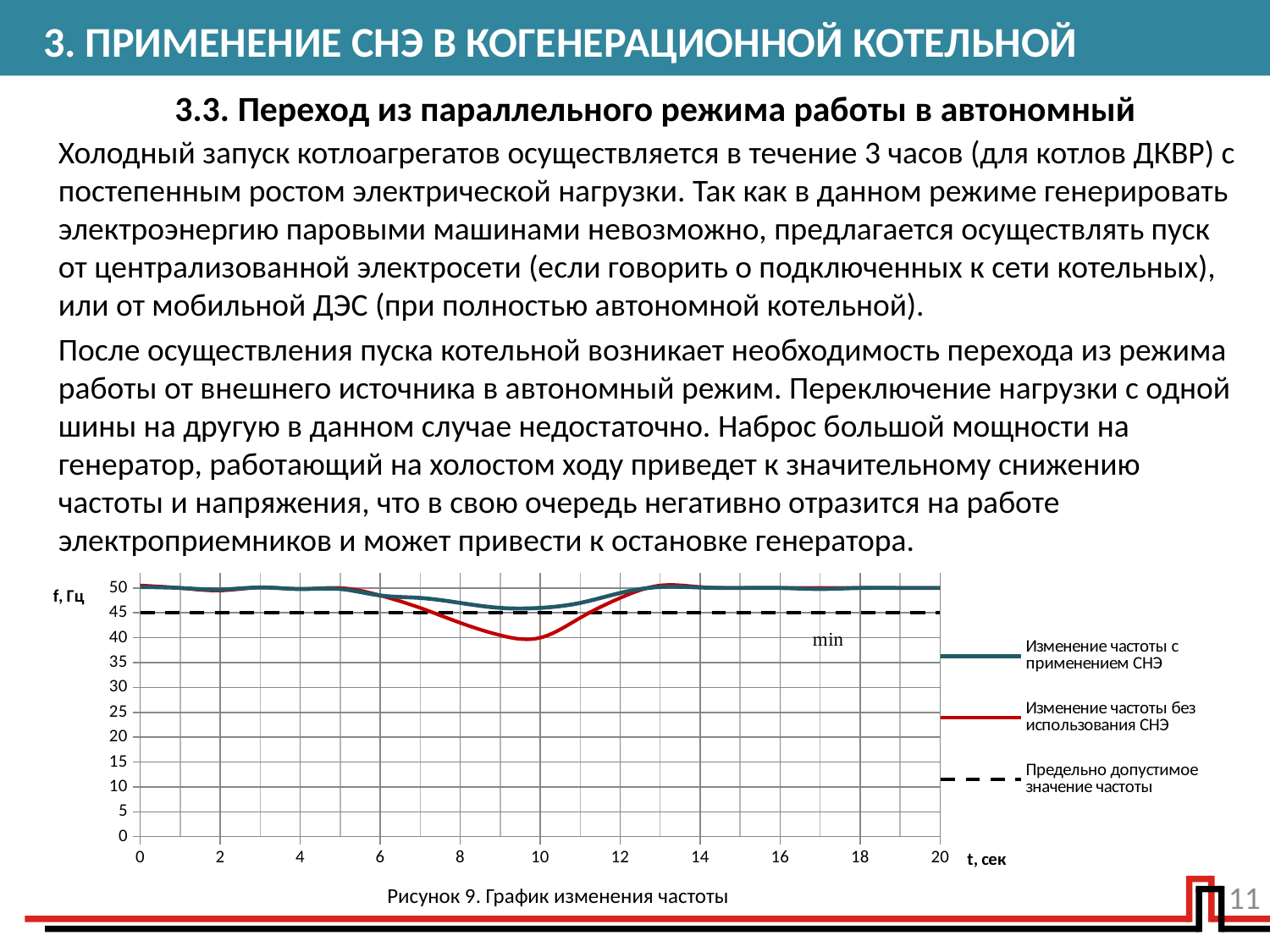
Is the value of the red line at t = 10 сек greater or less than 35? greater What value does the dashed line 'Предельно допустимое значение частоты' sit at on the y axis? 45 How many series does the chart legend list? 3 At t = 10 сек, which line is higher: 'Изменение частоты с применением СНЭ' or 'Изменение частоты без использования СНЭ'? Изменение частоты с применением СНЭ Is the lowest value of the teal line 'Изменение частоты с применением СНЭ' greater or less than 45? greater What is the caption of the chart (figure title) on the slide? Рисунок 9. График изменения частоты Between t = 10 and t = 13 сек, does the red line 'Изменение частоты без использования СНЭ' rise or fall? rise What kind of chart is shown on the slide? line chart Is the lowest value of the red line 'Изменение частоты без использования СНЭ' greater or less than 45? less What is the label of the x axis of the chart? t, сек What is the highest tick value shown on the x axis? 20 Between t = 5 and t = 10 сек, does the red line 'Изменение частоты без использования СНЭ' rise or fall? fall